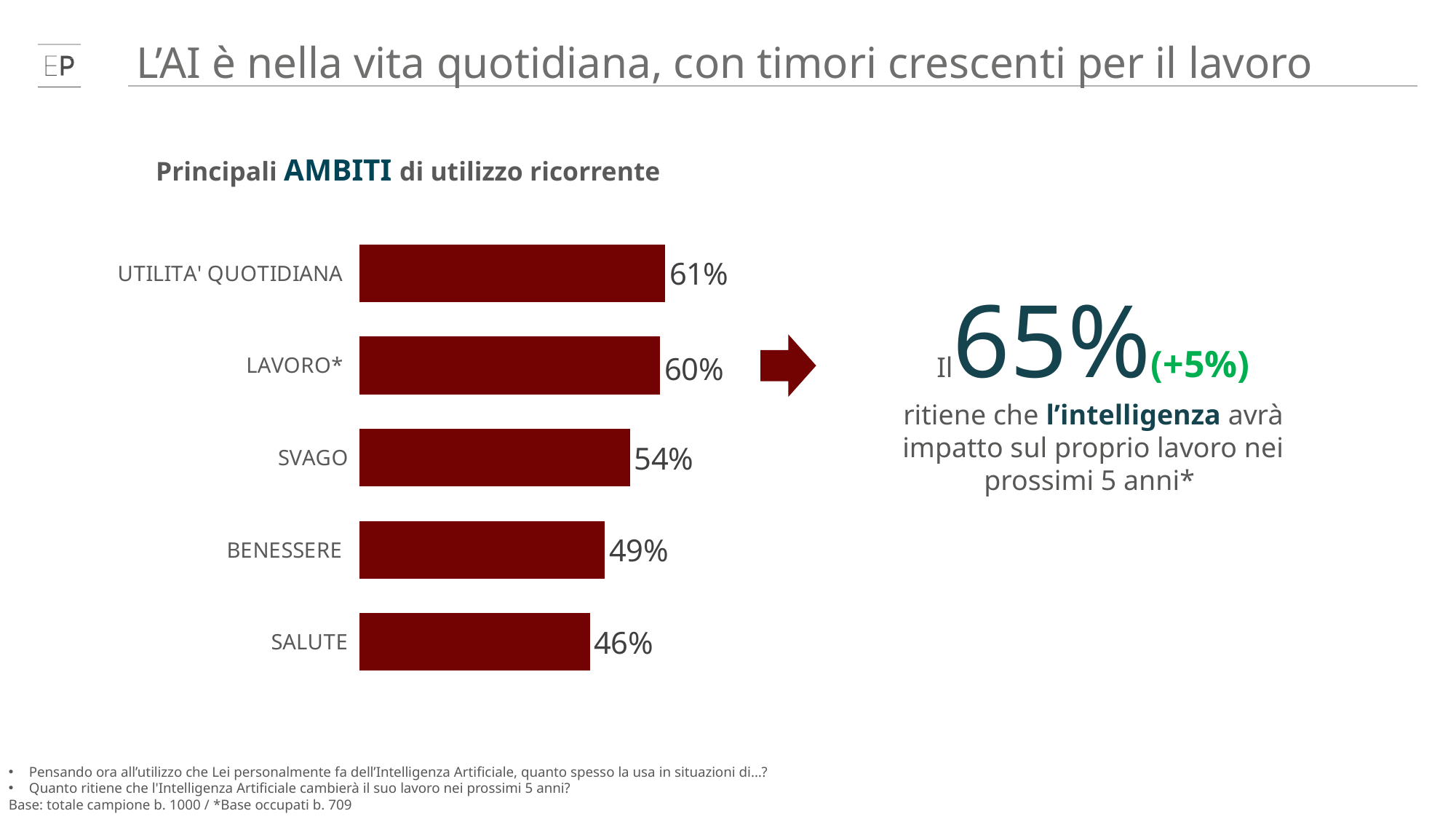
What is the value for UTILITA' QUOTIDIANA? 61% What is the value for BENESSERE? 49% What is the difference between the values for UTILITA' QUOTIDIANA and SALUTE? 15% What is the title of the chart? Principali AMBITI di utilizzo ricorrente What kind of chart is shown on the slide? bar chart What is the value for LAVORO*? 60% Which category has the lowest value? SALUTE What is the value for SVAGO? 54% Which is larger, the value for SVAGO or the value for SALUTE? SVAGO How many categories are shown in the chart? 5 What is the value for SALUTE? 46% What is the difference between the values for SVAGO and BENESSERE? 5%